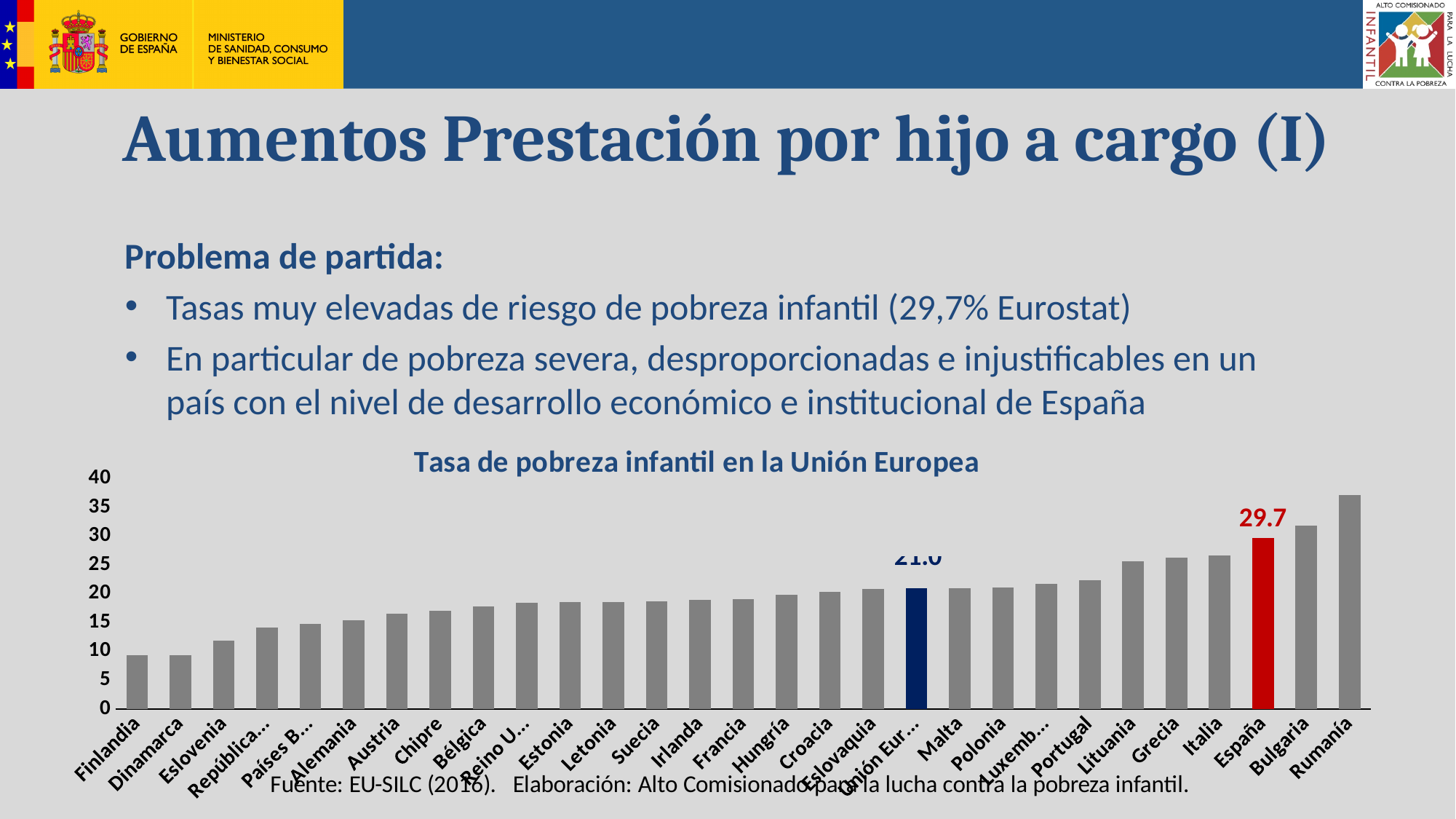
What kind of chart is shown on the slide? Bar chart Is the value for Finlandia greater or less than 10? less How many countries or regions are shown as bars in the chart? 29 Is the value for Portugal greater or less than 20? greater Is the value for Bulgaria greater or less than 30? greater Which country has the highest child poverty rate in the chart? Rumanía Which has a higher value, España or Bulgaria? Bulgaria Do the values generally rise or fall from left to right along the x axis? Rise What is the value shown for España in the chart? 29.7 Which has a higher value, España or Italia? España